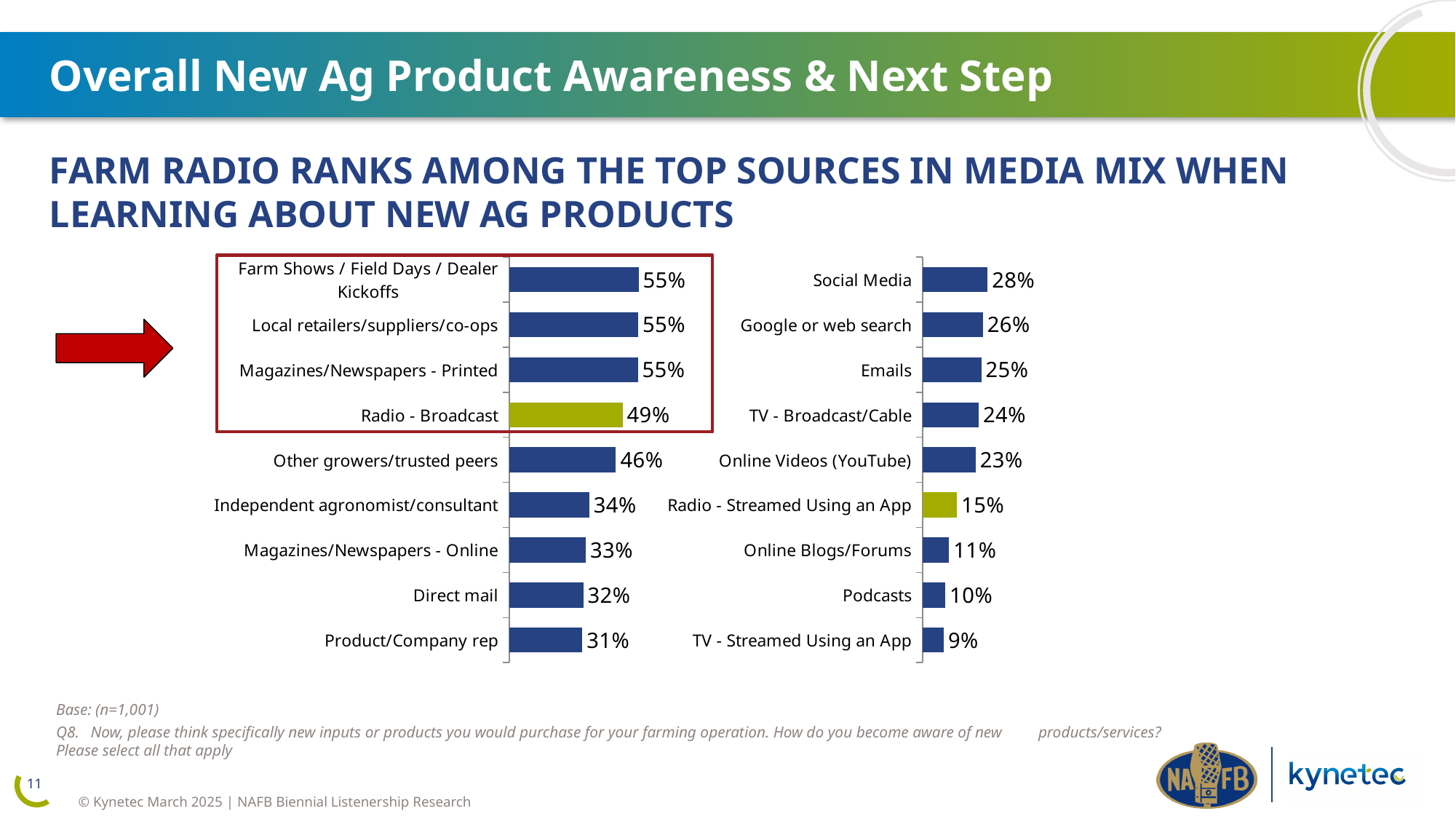
Which is larger: Radio - Broadcast in the left chart or Radio - Streamed Using an App in the right chart? Radio - Broadcast In the left chart, which category has the lowest value? Product/Company rep In the right chart, what is the value for Emails? 25% In the left chart, what is the value for Radio - Broadcast? 49% In the right chart, which category has the highest value? Social Media In the left chart, what is the difference between Magazines/Newspapers - Printed and Magazines/Newspapers - Online? 22% In the right chart, what is the difference between Social Media and Podcasts? 18% How many categories are shown in the right chart? 9 In the right chart, what is the value for Radio - Streamed Using an App? 15% In the left chart, what is the value for Other growers/trusted peers? 46% What type of chart is the left chart? Bar chart In the right chart, which category has the lowest value? TV - Streamed Using an App